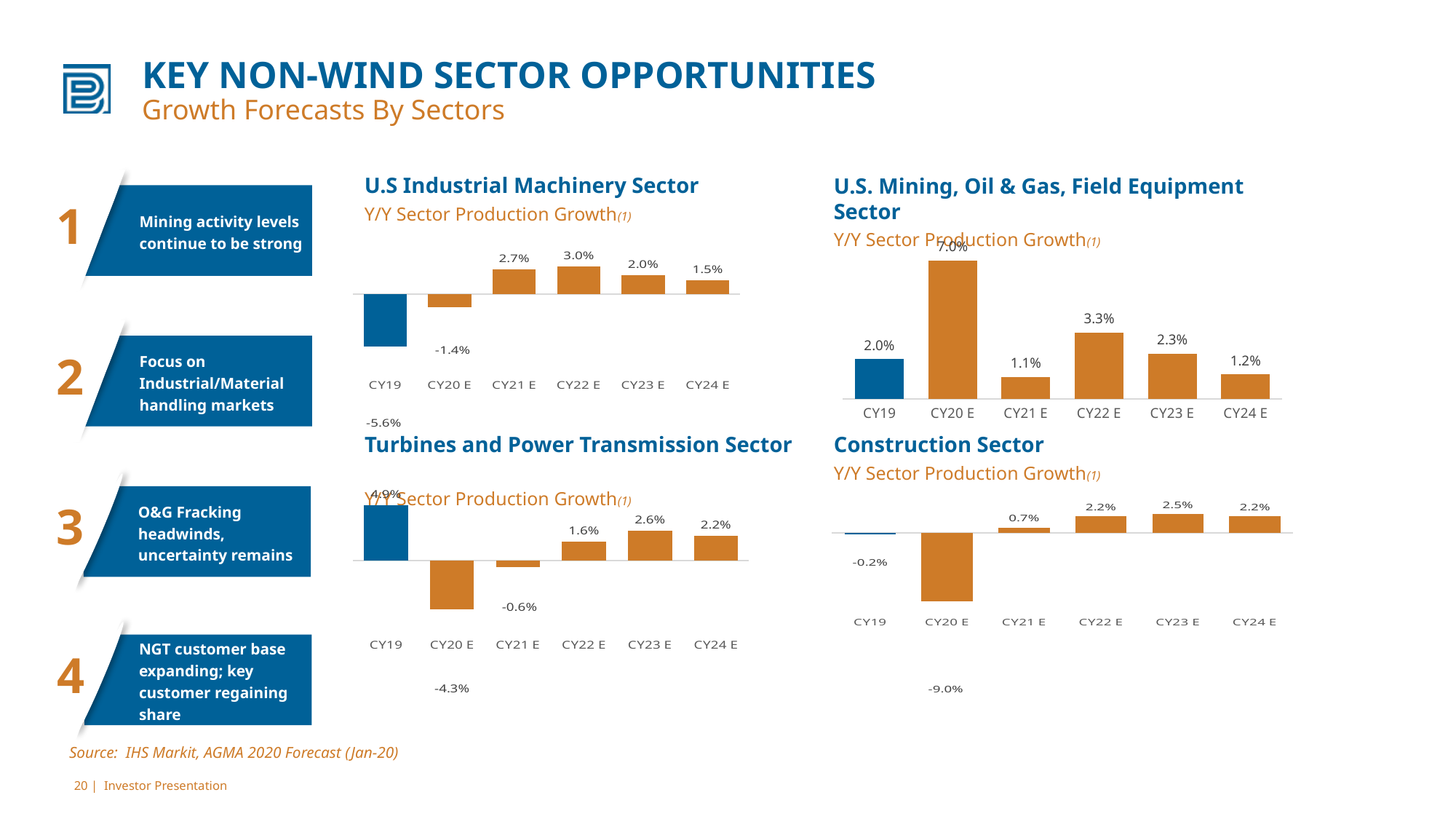
In the Construction Sector chart, which year has the highest value? CY23 E In the Turbines and Power Transmission Sector chart, which is larger, the value for CY23 E or CY24 E? CY23 E In the U.S. Mining, Oil & Gas, Field Equipment Sector chart, what is the value for CY20 E? 7.0% In the U.S Industrial Machinery Sector chart, which year has the highest value? CY22 E How many years are shown on the x axis of the Construction Sector chart? 6 In the U.S Industrial Machinery Sector chart, what is the value for CY22 E? 3.0% In the U.S. Mining, Oil & Gas, Field Equipment Sector chart, what is the difference between the CY22 E and CY23 E values? 1.0% In the Turbines and Power Transmission Sector chart, what is the value for CY20 E? -4.3% In the Construction Sector chart, what is the value for CY20 E? -9.0% What type of chart is the U.S Industrial Machinery Sector chart? Bar chart In the U.S Industrial Machinery Sector chart, what is the value for CY19? -5.6% In the U.S. Mining, Oil & Gas, Field Equipment Sector chart, which year has the lowest value? CY21 E